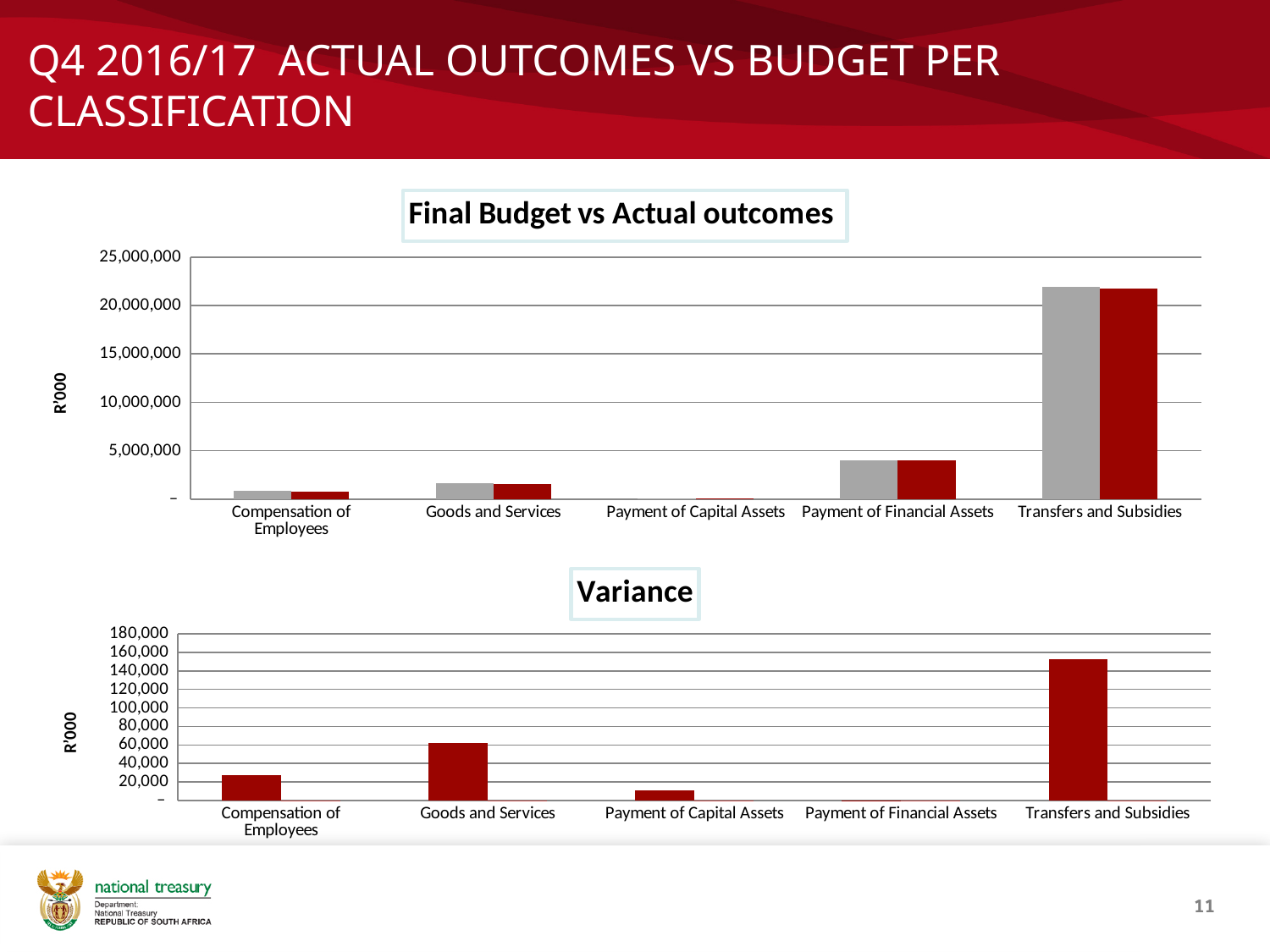
In the Variance chart, which category has the highest variance? Transfers and Subsidies In the Variance chart, which category has the lowest variance? Payment of Financial Assets In the Final Budget vs Actual outcomes chart, how many categories are shown on the x axis? 5 What kind of chart is the Final Budget vs Actual outcomes chart? bar chart In the Variance chart, is the value for Goods and Services greater or less than 80,000? less In the Final Budget vs Actual outcomes chart, which category has the lowest values? Payment of Capital Assets In the Final Budget vs Actual outcomes chart, which category has the highest values? Transfers and Subsidies In the Final Budget vs Actual outcomes chart, are the values for Transfers and Subsidies greater or less than 20,000,000? greater In the Variance chart, is the value for Transfers and Subsidies greater or less than 140,000? greater What unit is shown on the y axis label of the Variance chart? R'000 In the Variance chart, which is larger, the value for Goods and Services or the value for Compensation of Employees? Goods and Services